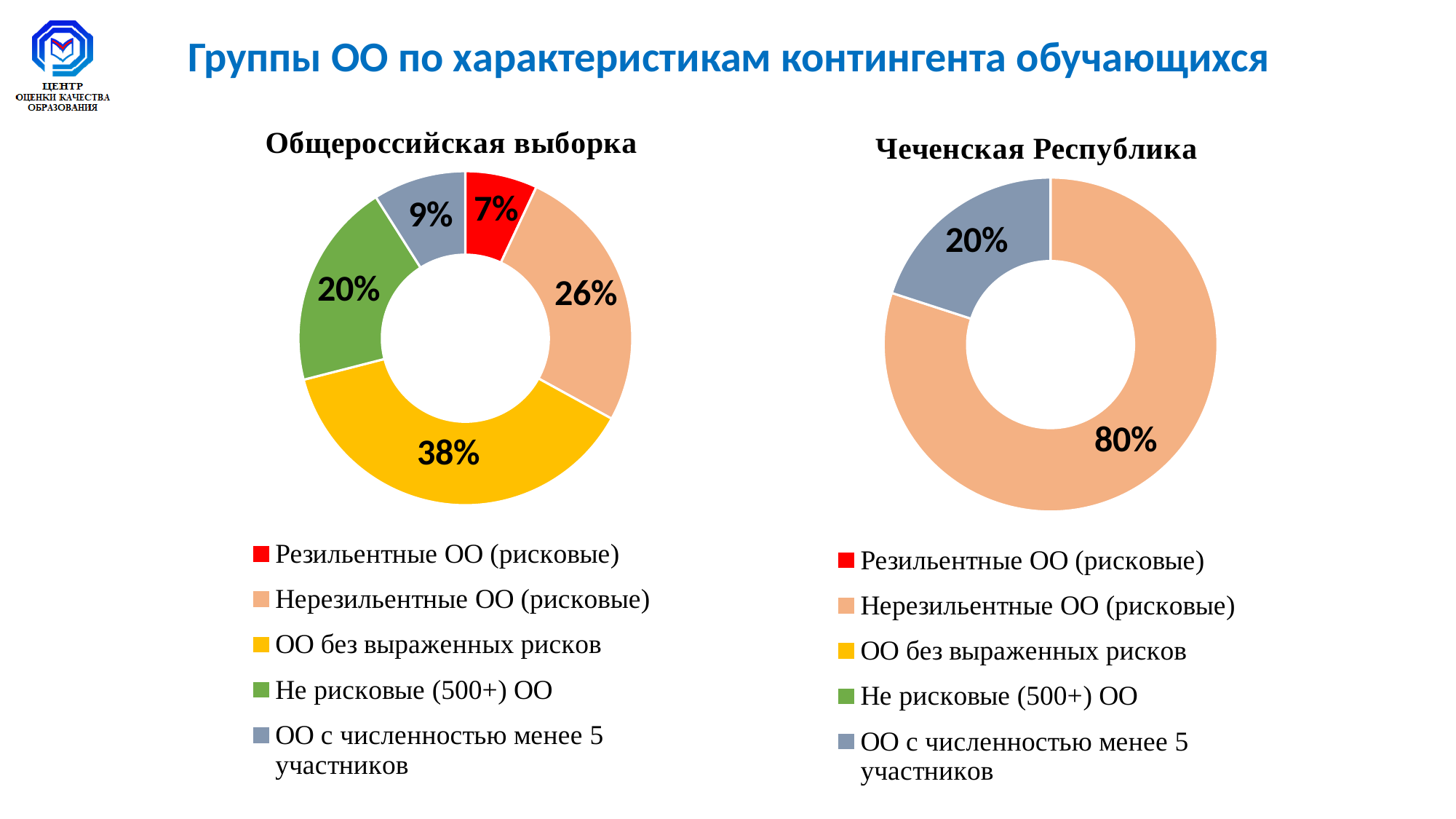
In the "Чеченская Республика" chart, what share is shown for "ОО с численностью менее 5 участников"? 20% In the "Общероссийская выборка" chart, what is the difference between the shares of "ОО без выраженных рисков" and "Нерезильентные ОО (рисковые)"? 12% In the "Чеченская Республика" chart, which is larger: the share of "Нерезильентные ОО (рисковые)" or "ОО с численностью менее 5 участников"? Нерезильентные ОО (рисковые) What type of chart is the "Чеченская Республика" chart? Doughnut (pie) chart In the "Общероссийская выборка" chart, what share is shown for "Не рисковые (500+) ОО"? 20% In the "Общероссийская выборка" chart, what share is shown for "ОО без выраженных рисков"? 38% In the "Общероссийская выборка" chart, which category has the smallest share? Резильентные ОО (рисковые) In the "Чеченская Республика" chart, what share is shown for "Нерезильентные ОО (рисковые)"? 80% In the "Общероссийская выборка" chart, which category has the largest share? ОО без выраженных рисков In the "Общероссийская выборка" chart, what share is shown for "Резильентные ОО (рисковые)"? 7% How many slices with data labels does the "Общероссийская выборка" chart have? 5 How many entries does the legend of the "Чеченская Республика" chart list? 5